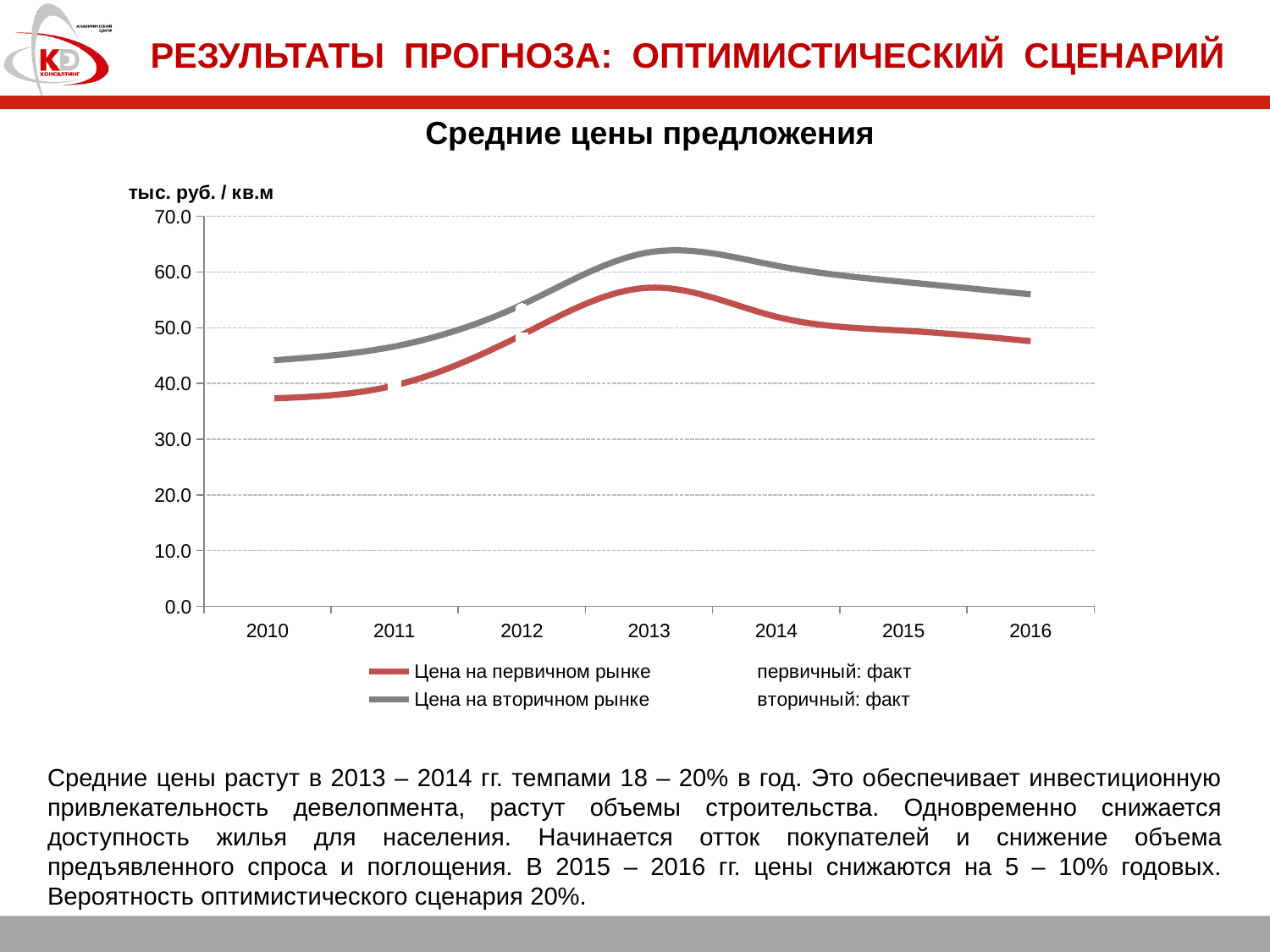
Is the value for 'Цена на первичном рынке' in 2016 greater or less than 50.0? less In which year does the line 'Цена на первичном рынке' reach its highest value? 2013 What is the title of the chart? Средние цены предложения In which year does the line 'Цена на вторичном рынке' reach its highest value? 2013 How many years are shown on the x axis of the chart? 7 Is the value for 'Цена на вторичном рынке' in 2010 greater or less than 40.0? greater Which line is higher in 2013, 'Цена на первичном рынке' or 'Цена на вторичном рынке'? Цена на вторичном рынке How many entries does the chart legend list? 4 What kind of chart is shown on the slide? line chart Is the value for 'Цена на вторичном рынке' in 2013 greater or less than 60.0? greater What unit is shown above the vertical axis of the chart? тыс. руб. / кв.м